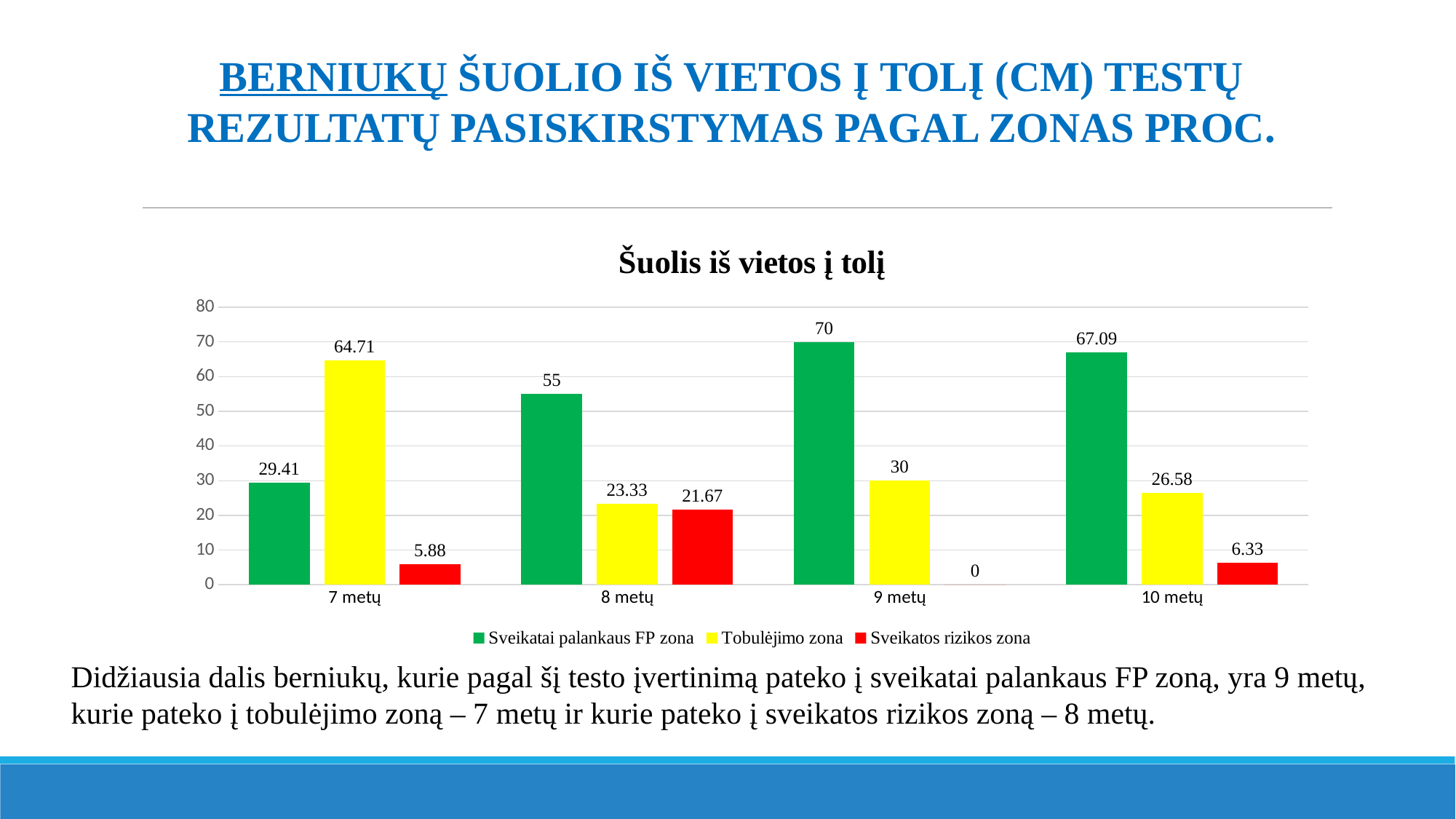
Is the value for Sveikatai palankaus FP zona for 10 metų greater or less than 60? greater Which is larger for 8 metų: Tobulėjimo zona or Sveikatos rizikos zona? Tobulėjimo zona What kind of chart is shown? bar chart What is the difference between the Tobulėjimo zona values for 7 metų and 8 metų? 41.38 Which age group has the lowest value for Sveikatos rizikos zona? 9 metų What is the value for Sveikatai palankaus FP zona for 7 metų? 29.41 Which age group has the highest value for Sveikatai palankaus FP zona? 9 metų What is the title of the chart? Šuolis iš vietos į tolį How many age groups are shown on the x axis? 4 What is the value for Sveikatos rizikos zona for 9 metų? 0 How many series does the legend list? 3 What is the value for Tobulėjimo zona for 10 metų? 26.58